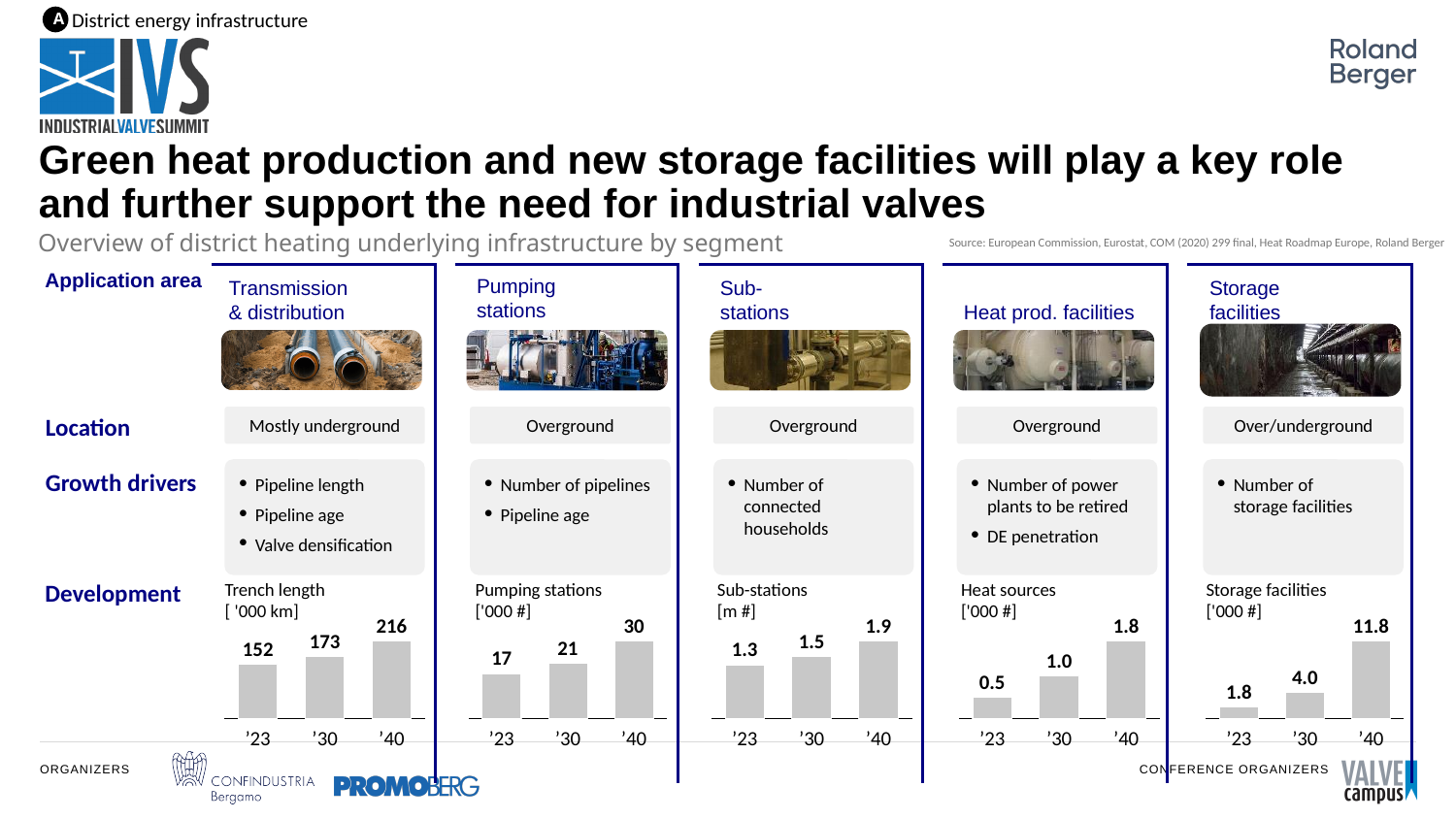
In the Trench length chart, what is the difference between the '40 and '23 values? 64 In the Pumping stations chart, which year has the lowest value? '23 In the Sub-stations chart, do the values rise or fall from '23 to '40? rise In the Heat sources chart, what is the difference between the '40 and '30 values? 0.8 In the Storage facilities chart, what is the value for '40? 11.8 In the Pumping stations chart, what is the value for '30? 21 How many bars does the Storage facilities chart show? 3 In the Trench length chart, what is the value for '40? 216 In the Storage facilities chart, which is larger, the value for '30 or the value for '23? '30 In the Heat sources chart, what is the value for '23? 0.5 In the Sub-stations chart, what is the value for '40? 1.9 What type of chart is the Trench length chart? bar chart